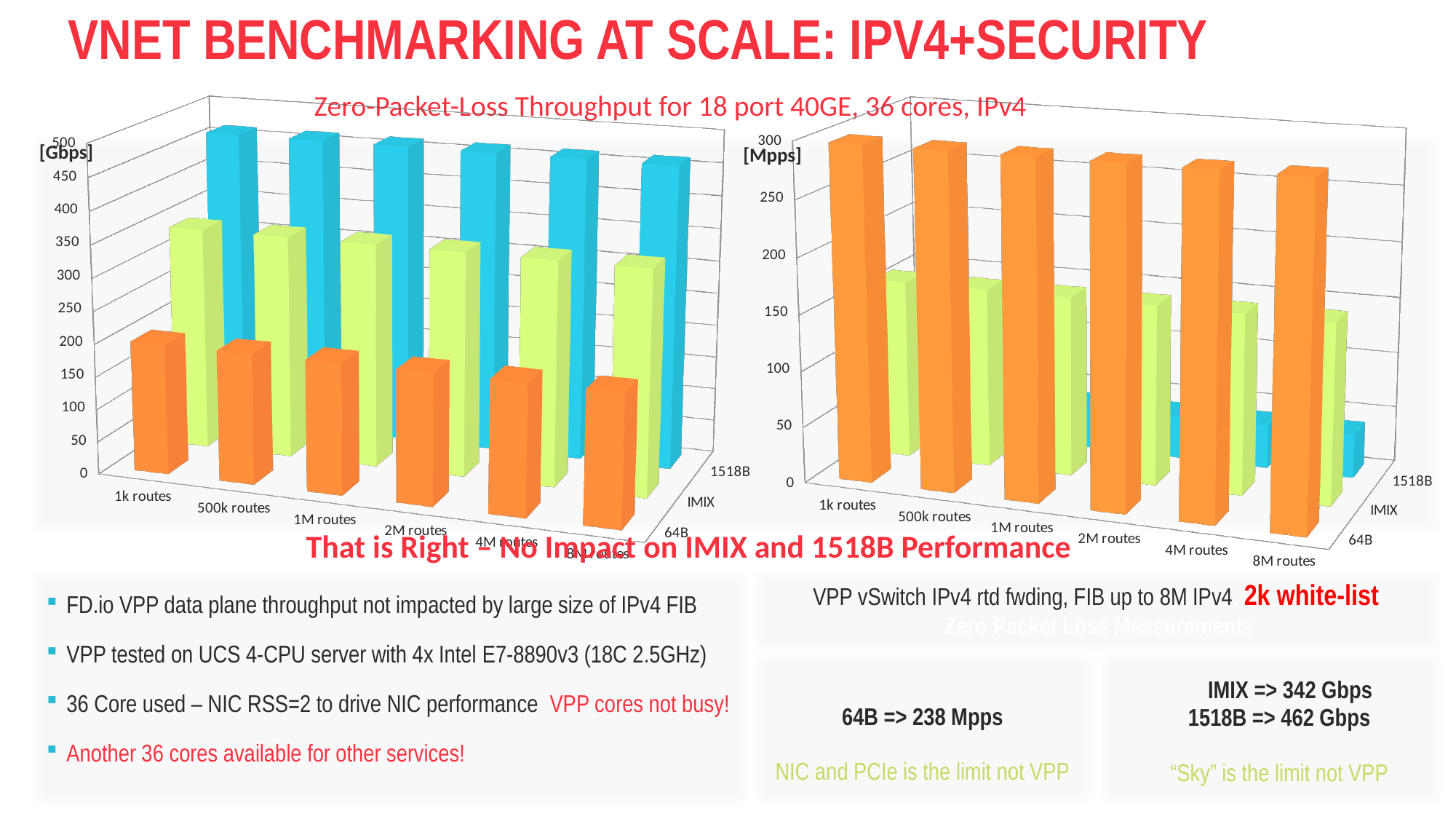
What is the shared title above the two charts? Zero-Packet-Loss Throughput for 18 port 40GE, 36 cores, IPv4 In the left chart (in Gbps), do the 64B bars rise or fall as the number of routes increases from 1k to 8M? Neither; they stay flat (constant across all route sizes) In the left chart (in Gbps), which packet-size series has the highest bars? 1518B In the right chart (in Mpps), is the 1518B value for 8M routes greater or less than 100? less In the right chart (in Mpps), which is larger at 8M routes: the 64B bar or the IMIX bar? 64B In the right chart (in Mpps), is the 64B value for 1k routes greater or less than 250? greater In the right chart (in Mpps), which packet-size series has the lowest bars? 1518B In the left chart (in Gbps), which is larger at 1k routes: the 64B bar or the 1518B bar? 1518B How many route-size categories are shown along the x axis of the left chart (in Gbps)? 6 What kind of chart is the left chart (in Gbps)? bar chart In the left chart (in Gbps), is the 1518B value for 1k routes greater or less than 400? greater How many packet-size series are plotted in the right chart (in Mpps)? 3